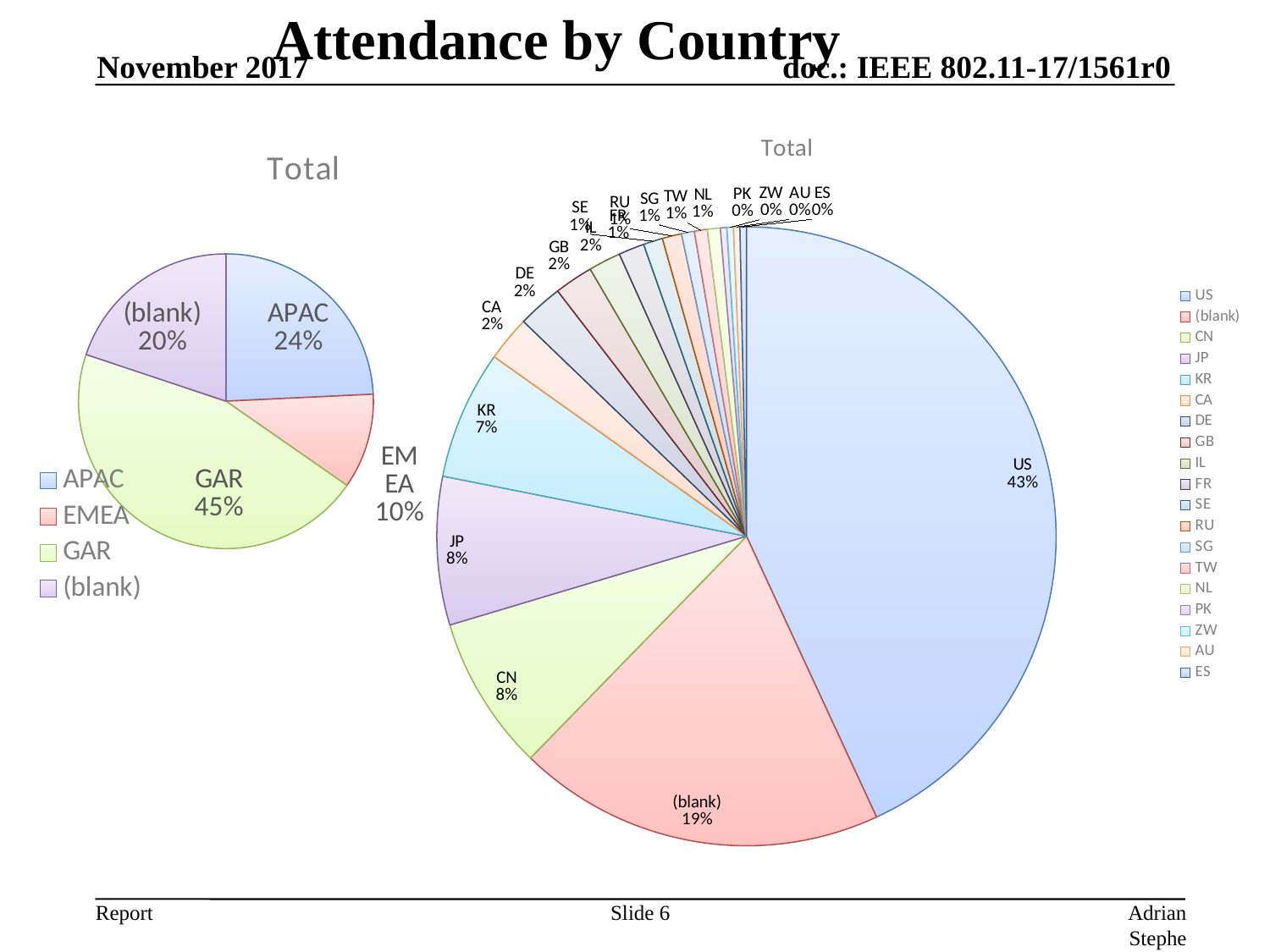
How many categories does the legend of the left pie chart list? 4 In the left pie chart, what share does GAR have? 45% In the right pie chart, what share does US have? 43% In the left pie chart, what is the difference between the APAC and (blank) shares? 4% What type of chart is the right chart on the slide? Pie chart In the right pie chart, what share does KR have? 7% In the left pie chart, what share does EMEA have? 10% In the right pie chart, which country has the largest share? US In the left pie chart, which region has the largest share? GAR In the right pie chart, which is larger, the share for (blank) or the share for CN? (blank) How many entries does the legend of the right pie chart list? 19 In the left pie chart, which region has the smallest share? EMEA